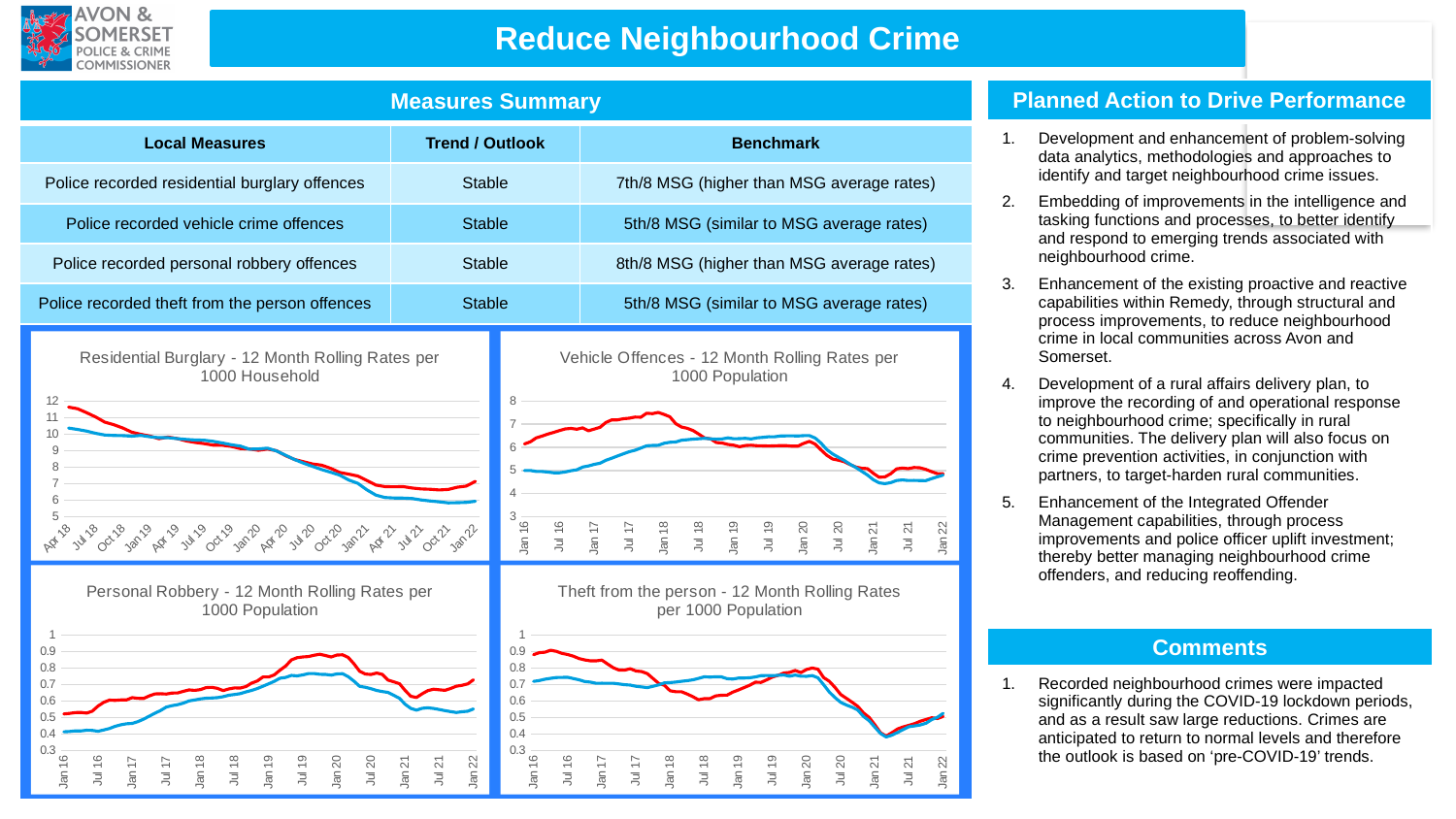
In the 'Residential Burglary - 12 Month Rolling Rates per 1000 Household' chart, do the values generally rise or fall from Apr 18 to Jan 22? fall In the 'Theft from the person - 12 Month Rolling Rates per 1000 Population' chart, is the red line's value at Jan 16 greater or less than 0.8? greater In the 'Residential Burglary - 12 Month Rolling Rates per 1000 Household' chart, is the blue line's value at Jan 22 greater or less than 7? less In the 'Vehicle Offences - 12 Month Rolling Rates per 1000 Population' chart, is the red line's peak value around Jan 18 greater or less than 7? greater How many charts are shown on the slide? 4 In the 'Personal Robbery - 12 Month Rolling Rates per 1000 Population' chart, does the red line rise or fall between Jan 16 and Jan 20? rise In the 'Theft from the person - 12 Month Rolling Rates per 1000 Population' chart, do the values generally rise or fall from Jan 16 to Jan 22? fall What kind of chart is the 'Residential Burglary - 12 Month Rolling Rates per 1000 Household' chart? line chart What is the highest value shown on the y axis of the 'Residential Burglary - 12 Month Rolling Rates per 1000 Household' chart? 12